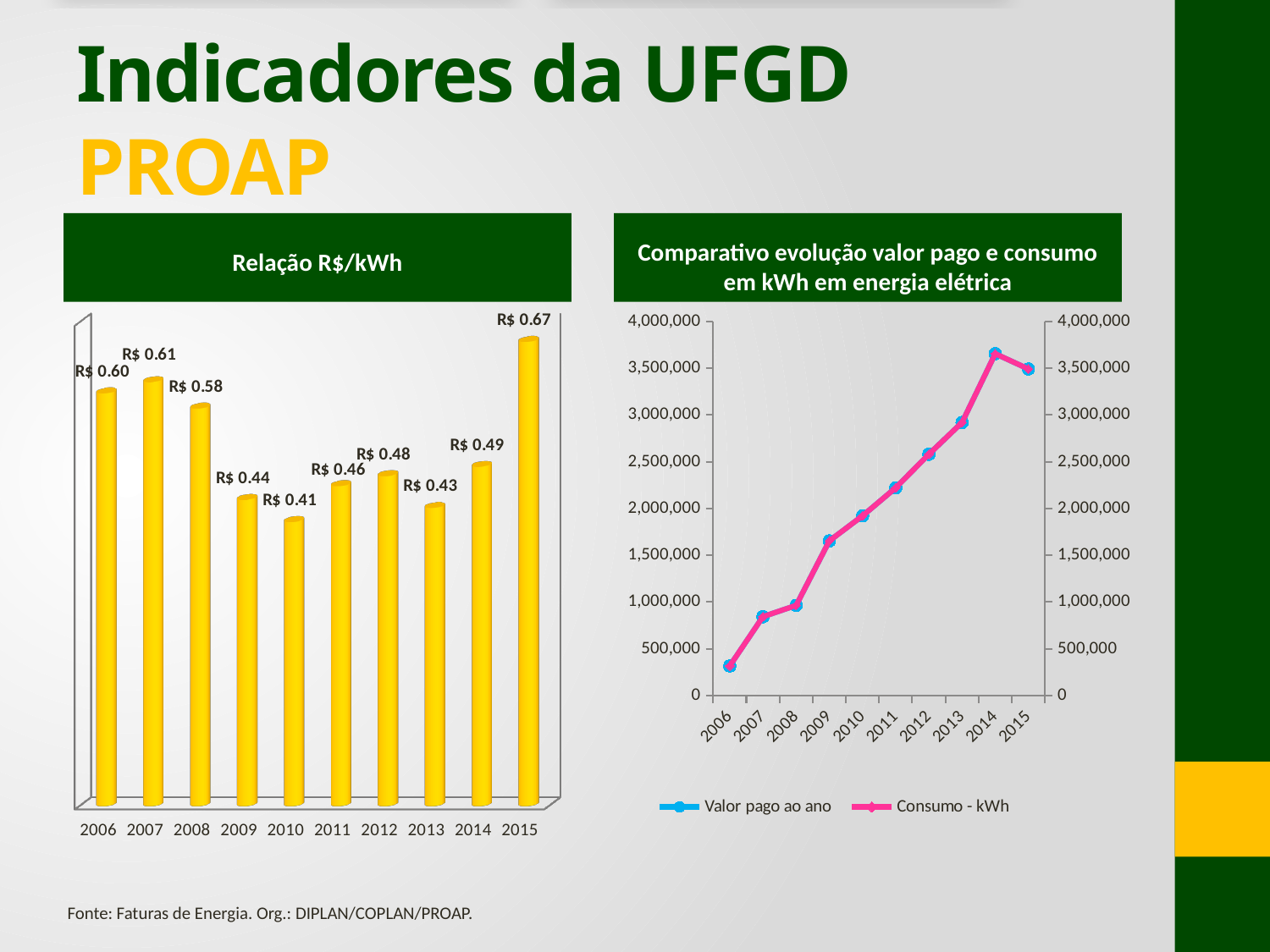
In the 'Relação R$/kWh' chart, what is the difference between the values for 2015 and 2014? R$ 0.18 In the 'Relação R$/kWh' chart, which year has the highest value? 2015 In the 'Relação R$/kWh' chart, which is larger, the value for 2009 or the value for 2013? 2009 What kind of chart is the 'Comparativo evolução valor pago e consumo em kWh em energia elétrica' chart? Line chart In the 'Comparativo evolução valor pago e consumo em kWh em energia elétrica' chart, is the value for 2014 greater or less than 3,500,000? greater How many years are shown in the 'Relação R$/kWh' chart? 10 In the 'Relação R$/kWh' chart, what is the value for 2010? R$ 0.41 How many series does the legend of the 'Comparativo evolução valor pago e consumo em kWh em energia elétrica' chart list? 2 What kind of chart is the 'Relação R$/kWh' chart? Bar chart In the 'Relação R$/kWh' chart, what is the value for 2015? R$ 0.67 In the 'Comparativo evolução valor pago e consumo em kWh em energia elétrica' chart, is the value for 2006 greater or less than 500,000? less In the 'Relação R$/kWh' chart, which year has the lowest value? 2010